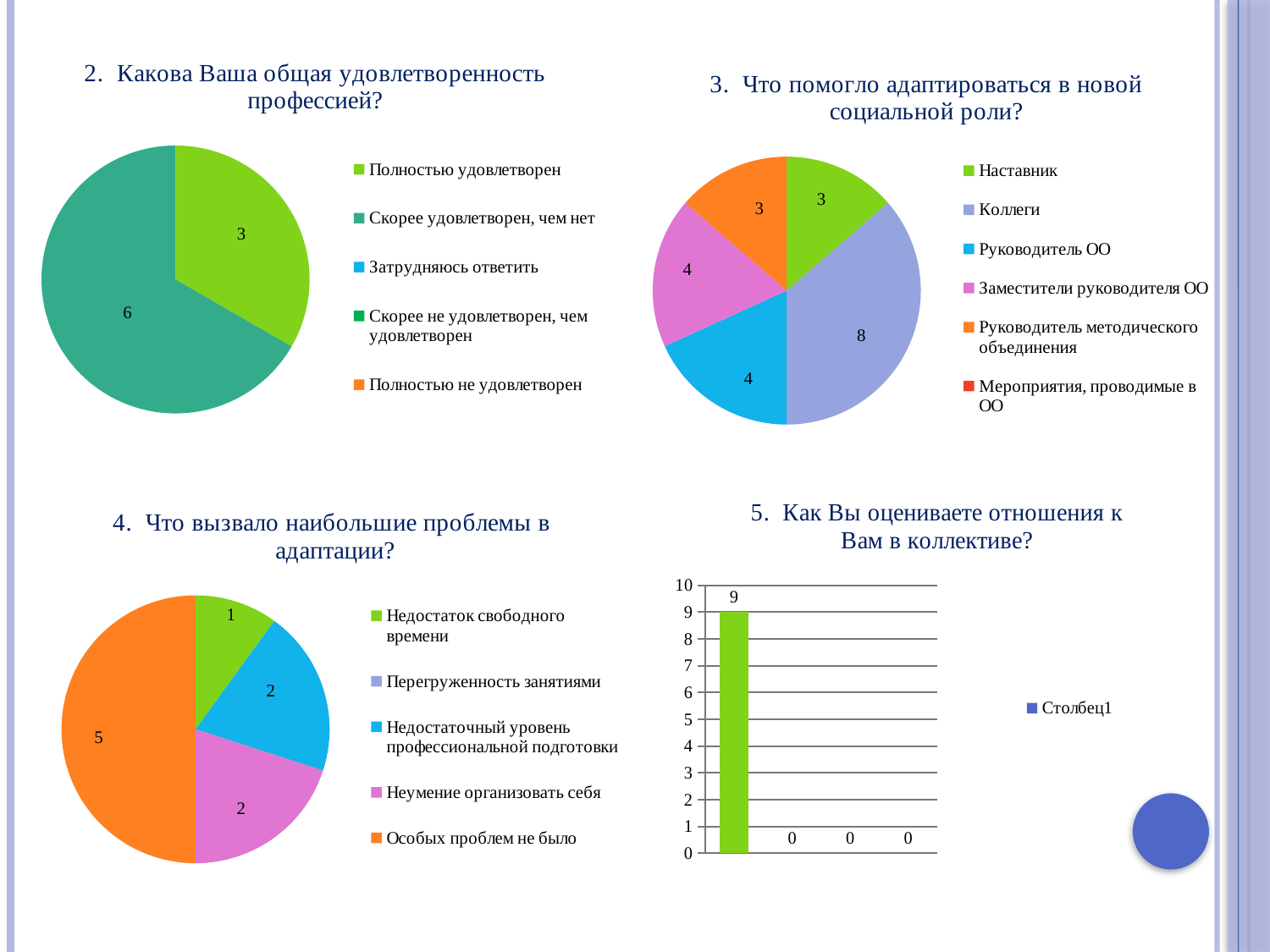
In the chart titled "4. Что вызвало наибольшие проблемы в адаптации?", what share of the pie does "Особых проблем не было" represent? 50% What series name does the legend show in the chart titled "5. Как Вы оцениваете отношения к Вам в коллективе?"? Столбец1 In the chart titled "2. Какова Ваша общая удовлетворенность профессией?", what is the value for "Скорее удовлетворен, чем нет"? 6 In the chart titled "3. Что помогло адаптироваться в новой социальной роли?", what is the value for "Коллеги"? 8 In the chart titled "4. Что вызвало наибольшие проблемы в адаптации?", what is the value for "Особых проблем не было"? 5 How many entries does the legend list in the chart titled "3. Что помогло адаптироваться в новой социальной роли?"? 6 In the chart titled "3. Что помогло адаптироваться в новой социальной роли?", which category has the largest slice? Коллеги In the chart titled "5. Как Вы оцениваете отношения к Вам в коллективе?", what is the value of the tallest bar? 9 In the chart titled "3. Что помогло адаптироваться в новой социальной роли?", what is the difference between the values for "Коллеги" and "Наставник"? 5 In the chart titled "4. Что вызвало наибольшие проблемы в адаптации?", which plotted category has the smallest slice? Недостаток свободного времени In the chart titled "2. Какова Ваша общая удовлетворенность профессией?", which of the two plotted slices is larger: "Полностью удовлетворен" or "Скорее удовлетворен, чем нет"? Скорее удовлетворен, чем нет What kind of chart is used for "5. Как Вы оцениваете отношения к Вам в коллективе?"? Bar chart